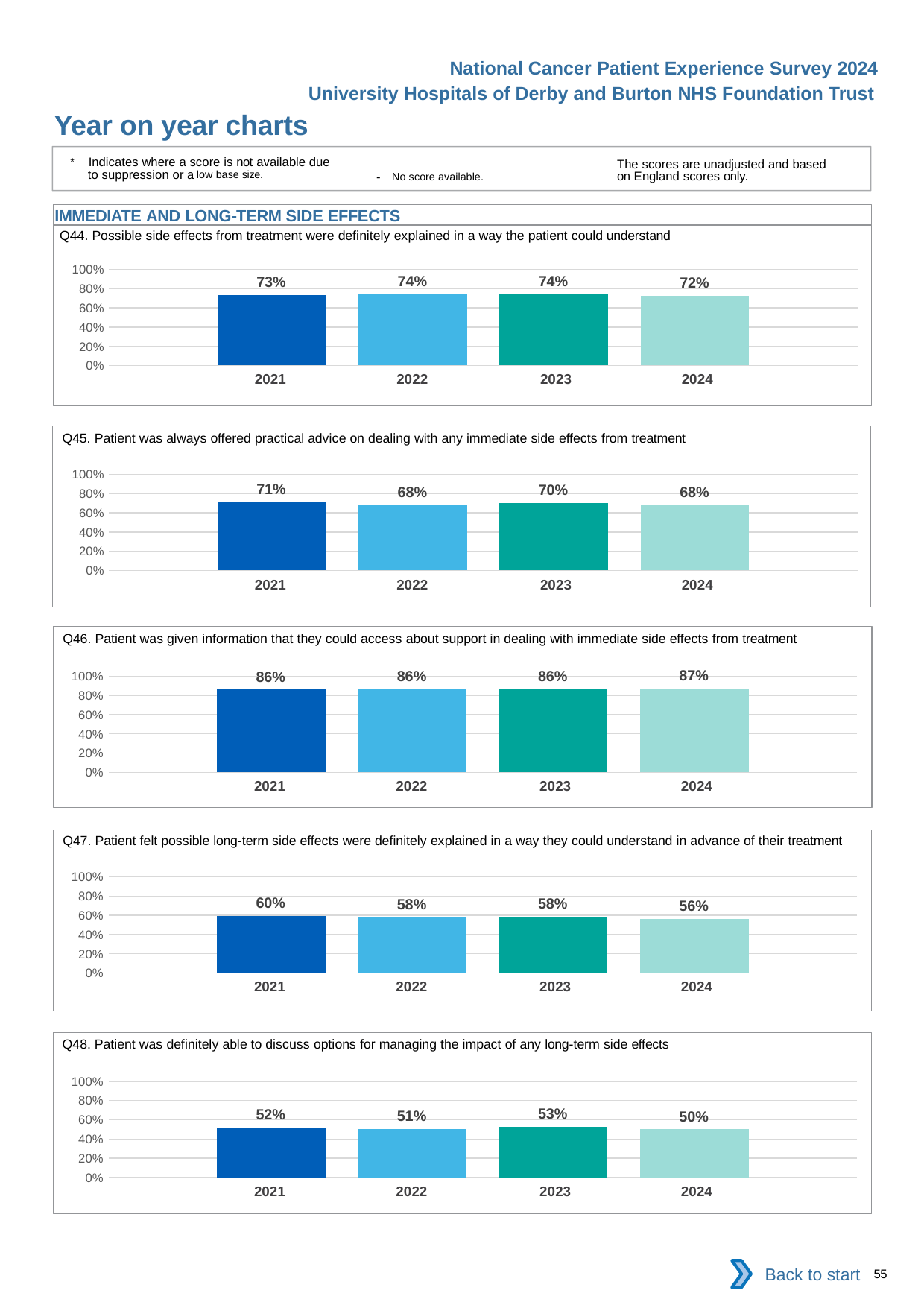
In the Q44 chart, how many years are plotted? 4 In the Q48 chart, is the value for 2023 larger or smaller than the value for 2022? larger What kind of chart is the Q45 chart? bar chart In the Q47 chart, do the values generally rise or fall from 2021 to 2024? fall In the Q46 chart, what is the value for 2024? 87% In the Q48 chart, which year has the lowest value? 2024 In the Q45 chart, which year has the highest value? 2021 In the Q44 chart, what is the value for 2021? 73% How many charts are shown on the slide? 5 In the Q45 chart, what is the value for 2023? 70% In the Q47 chart, what is the difference between the 2021 value and the 2024 value? 4% In the Q48 chart, is the value for 2021 greater or less than 60%? less